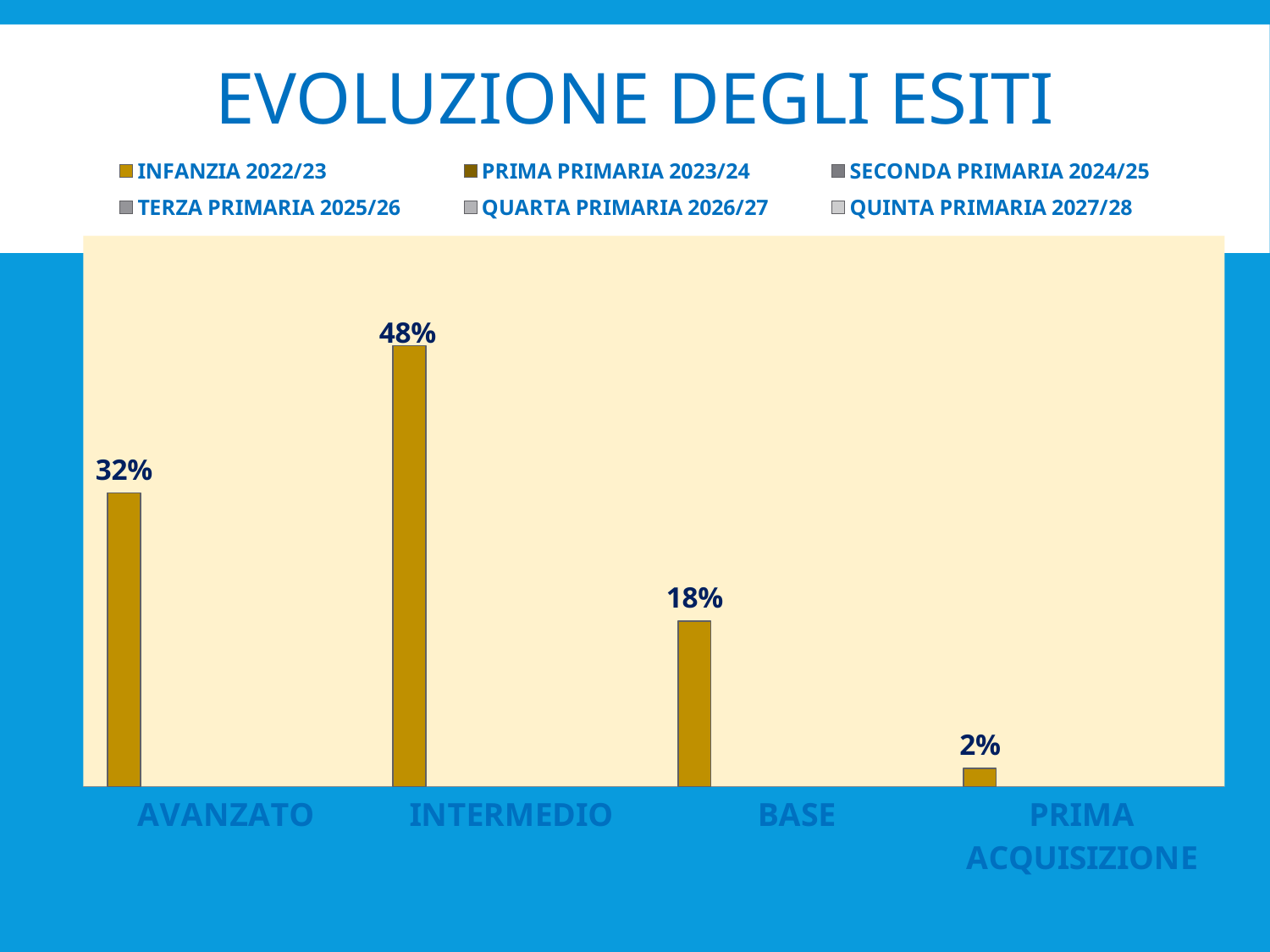
What is the value for BASE in the INFANZIA 2022/23 series? 18% What is the value for INTERMEDIO in the INFANZIA 2022/23 series? 48% Which category has the lowest value in the INFANZIA 2022/23 series? PRIMA ACQUISIZIONE What is the value for PRIMA ACQUISIZIONE in the INFANZIA 2022/23 series? 2% What is the value for AVANZATO in the INFANZIA 2022/23 series? 32% Which is larger in the INFANZIA 2022/23 series, BASE or AVANZATO? AVANZATO How many series does the chart legend list? 6 Which category has the highest value in the INFANZIA 2022/23 series? INTERMEDIO How many categories are shown on the x axis of the chart? 4 What is the difference between the INTERMEDIO and AVANZATO values in the INFANZIA 2022/23 series? 16% What is the title of the chart on the slide? EVOLUZIONE DEGLI ESITI What kind of chart is shown on the slide? Bar chart